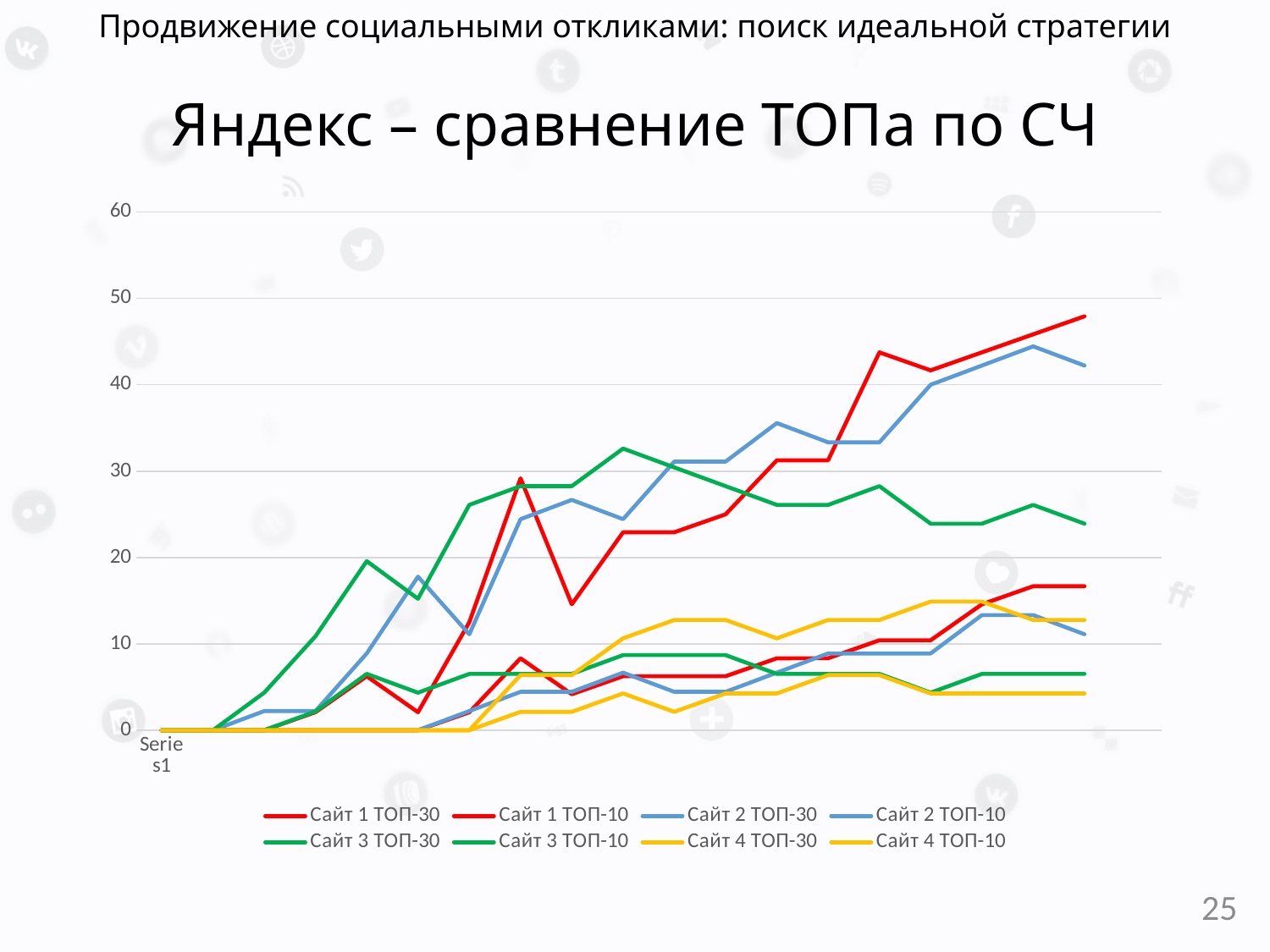
How many series does the legend list? 8 Is the highest yellow line's value at the right end greater or less than 20? less Is the highest value reached by any line on the chart greater or less than 50? less What kind of chart is shown on the slide? line chart Is the highest value at the right end of the chart greater or less than 40? greater Do the upper lines generally rise or fall from left to right? rise Which colour line reaches the highest value on the chart? red At the right end of the chart, is the highest green line above or below the highest blue line? below What is the title of the chart? Яндекс – сравнение ТОПа по СЧ Which site's series are drawn in green? Сайт 3